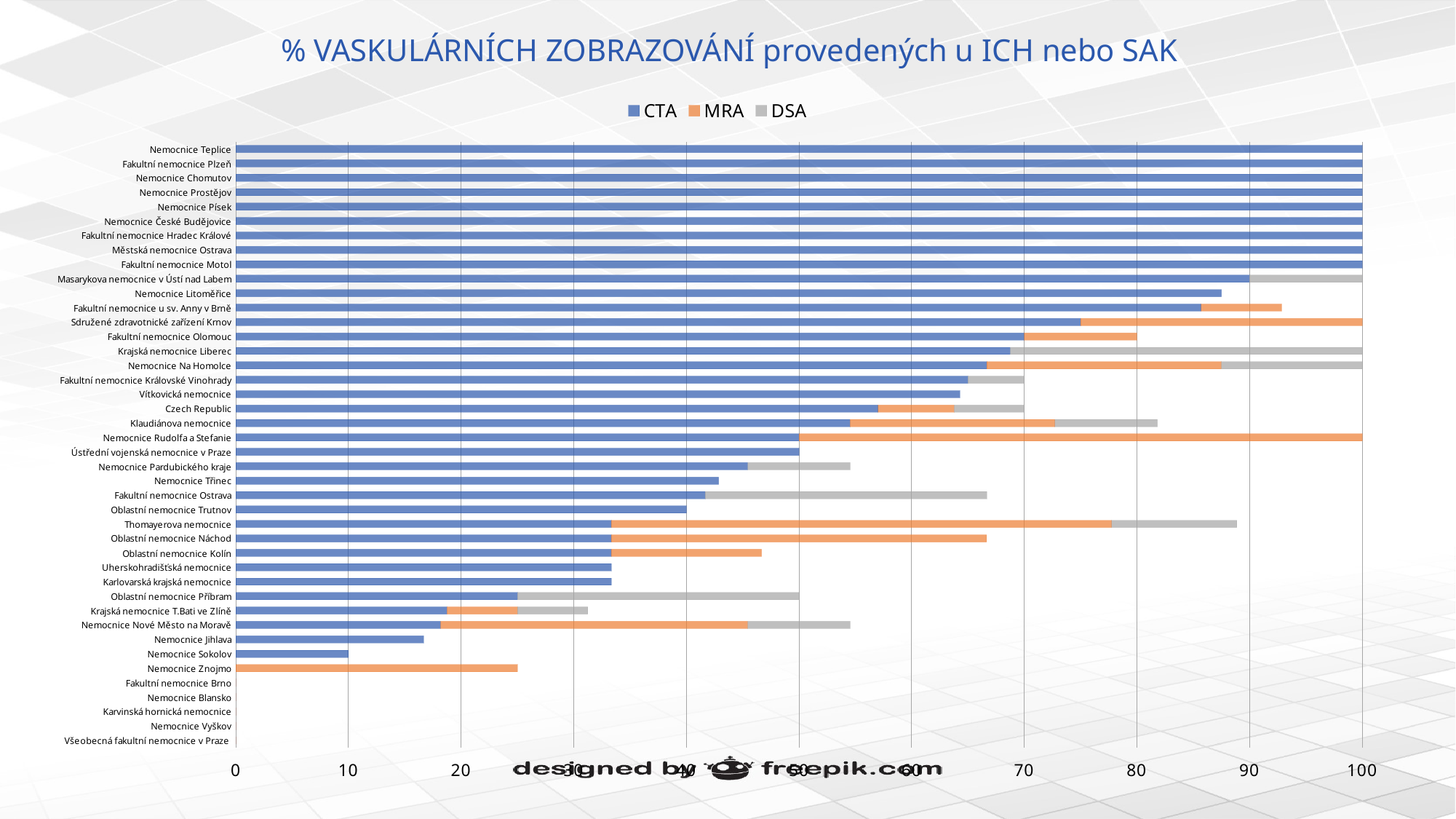
Which has the larger CTA value, Nemocnice Jihlava or Nemocnice Sokolov? Nemocnice Jihlava What is the CTA value for Nemocnice Sokolov? 10 Is the total of the stacked bar for Klaudiánova nemocnice greater or less than 80? greater What is the CTA value for Nemocnice Teplice? 100 What is the CTA value for Fakultní nemocnice Olomouc? 70 How many series does the legend list? 3 Which series is shown in orange? MRA What kind of chart is shown on the slide? bar chart Is the CTA value for Nemocnice Jihlava greater or less than 20? less Is the CTA value for Nemocnice Třinec greater or less than 40? greater What is the title of the chart? % VASKULÁRNÍCH ZOBRAZOVÁNÍ provedených u ICH nebo SAK What is the CTA value for Oblastní nemocnice Trutnov? 40